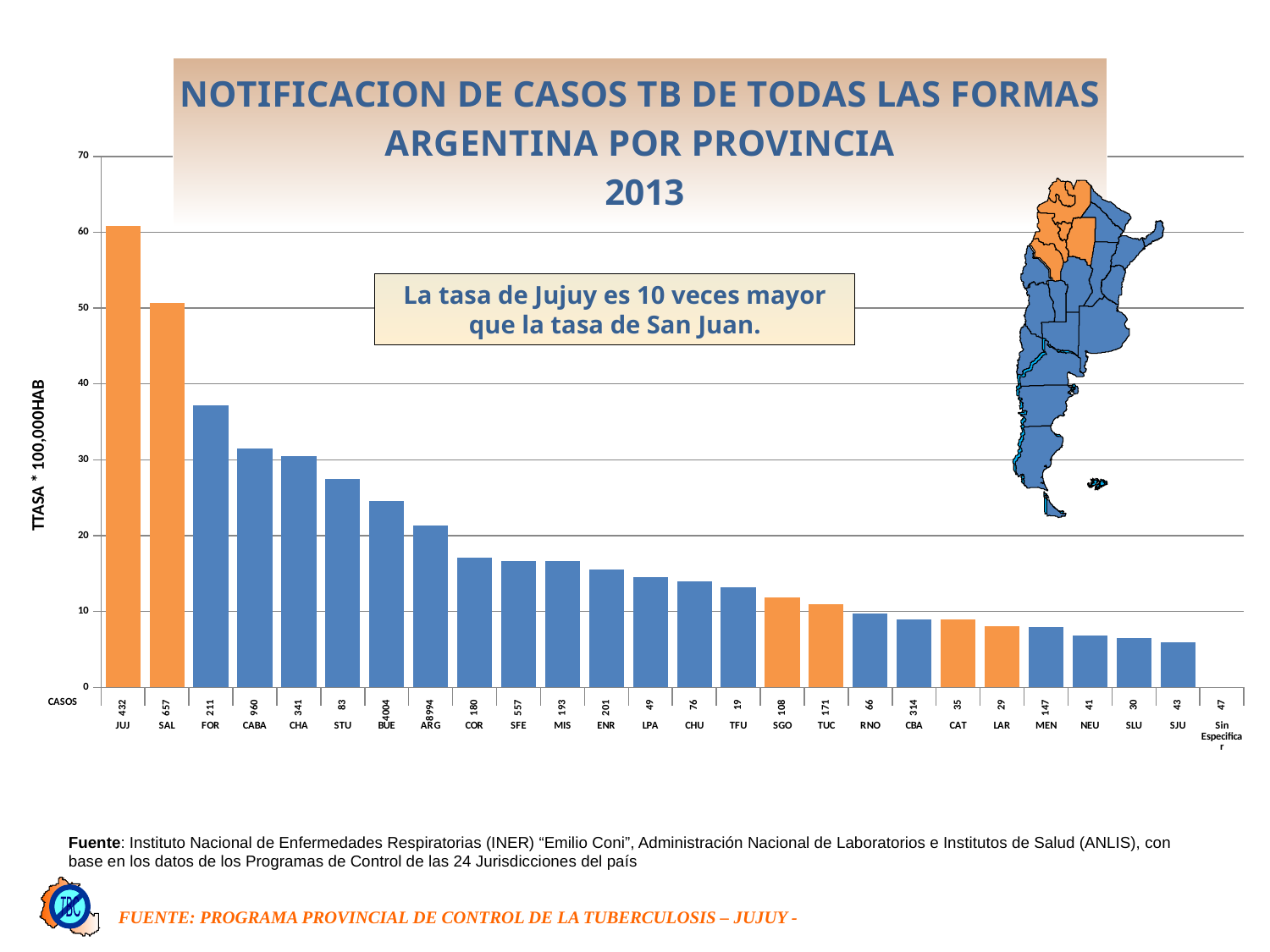
What is the label of the y axis? TTASA * 100,000HAB Which province has the highest TB notification rate in the chart? JUJ Do the rates rise or fall moving from left to right along the x axis? fall Is the rate for BUE greater or less than 30? less Is the rate for FOR greater or less than 40? less How many cases (CASOS) are shown for ARG? 8994 How many bars (categories) are plotted in the chart? 25 How many cases (CASOS) are shown for BUE? 4004 What kind of chart is shown on the slide? bar chart Is the rate for JUJ greater or less than 50? greater Which has the higher rate, JUJ or SAL? JUJ